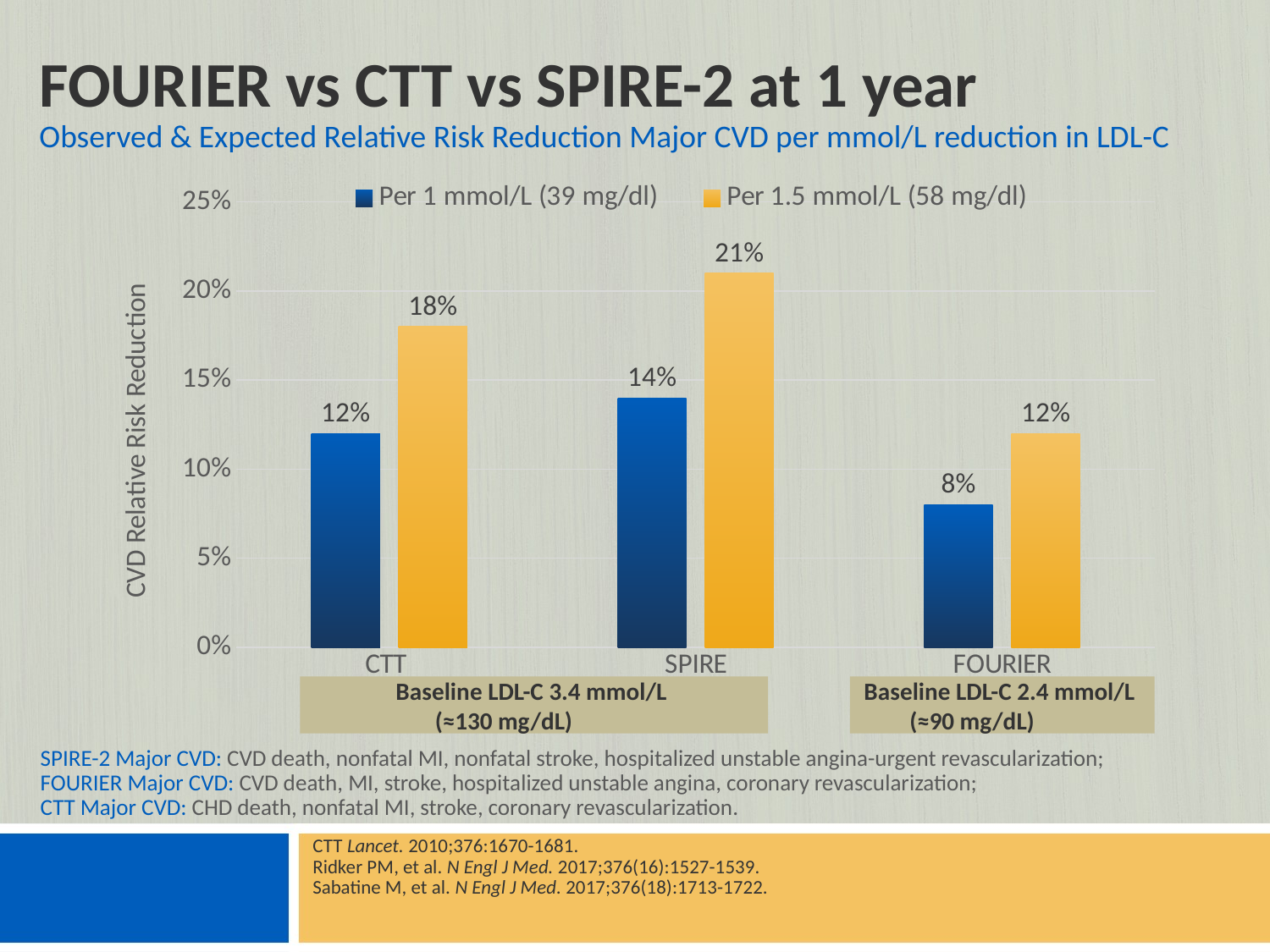
How many series does the legend list? 2 Which is larger: the per 1 mmol/L value for SPIRE or the per 1.5 mmol/L value for FOURIER? Per 1 mmol/L value for SPIRE Which trial has the highest relative risk reduction per 1 mmol/L? SPIRE What is the CVD relative risk reduction per 1 mmol/L for FOURIER? 8% What is the CVD relative risk reduction per 1 mmol/L for CTT? 12% How many trials are shown on the x axis? 3 What is the CVD relative risk reduction per 1.5 mmol/L for SPIRE? 21% What is the label of the y axis? CVD Relative Risk Reduction Which trial has the lowest relative risk reduction per 1.5 mmol/L? FOURIER What is the difference between the per 1.5 mmol/L and per 1 mmol/L values for SPIRE? 7% What is the CVD relative risk reduction per 1.5 mmol/L for CTT? 18% What kind of chart is shown on the slide? Bar chart